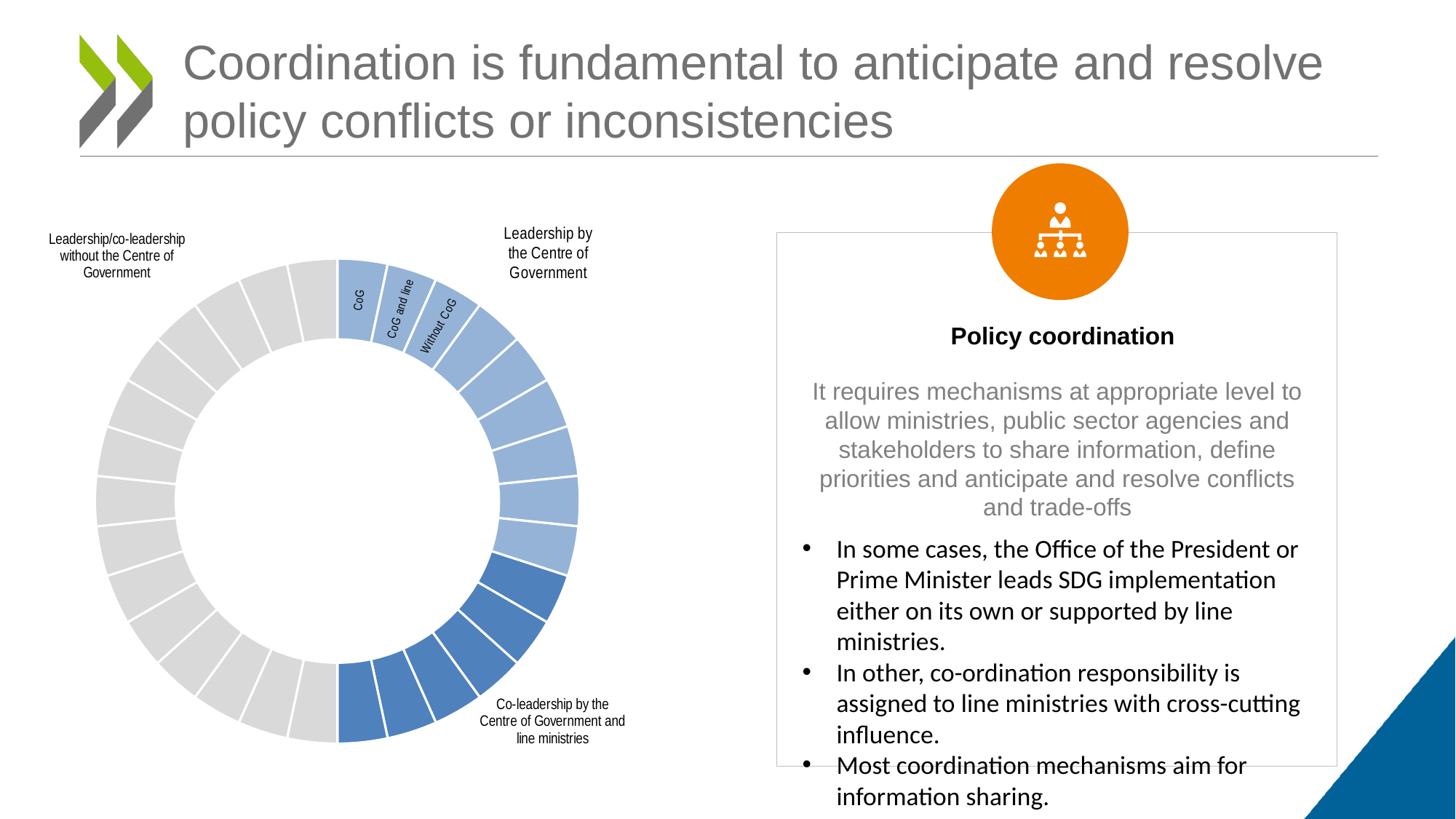
Which category occupies the smallest portion of the doughnut chart? Co-leadership by the Centre of Government and line ministries What colour is used for the 'Leadership/co-leadership without the Centre of Government' segments? Grey What kind of chart is shown on the left of the slide? Doughnut (ring) chart How many leadership categories does the doughnut chart distinguish? 3 Which portion of the ring is larger: 'Leadership by the Centre of Government' or 'Co-leadership by the Centre of Government and line ministries'? Leadership by the Centre of Government Which portion of the ring is larger: 'Leadership/co-leadership without the Centre of Government' or 'Leadership by the Centre of Government'? Leadership/co-leadership without the Centre of Government Which category occupies the largest portion of the doughnut chart? Leadership/co-leadership without the Centre of Government What are the three short labels written on the first segments at the top of the ring? CoG, CoG and line, Without CoG